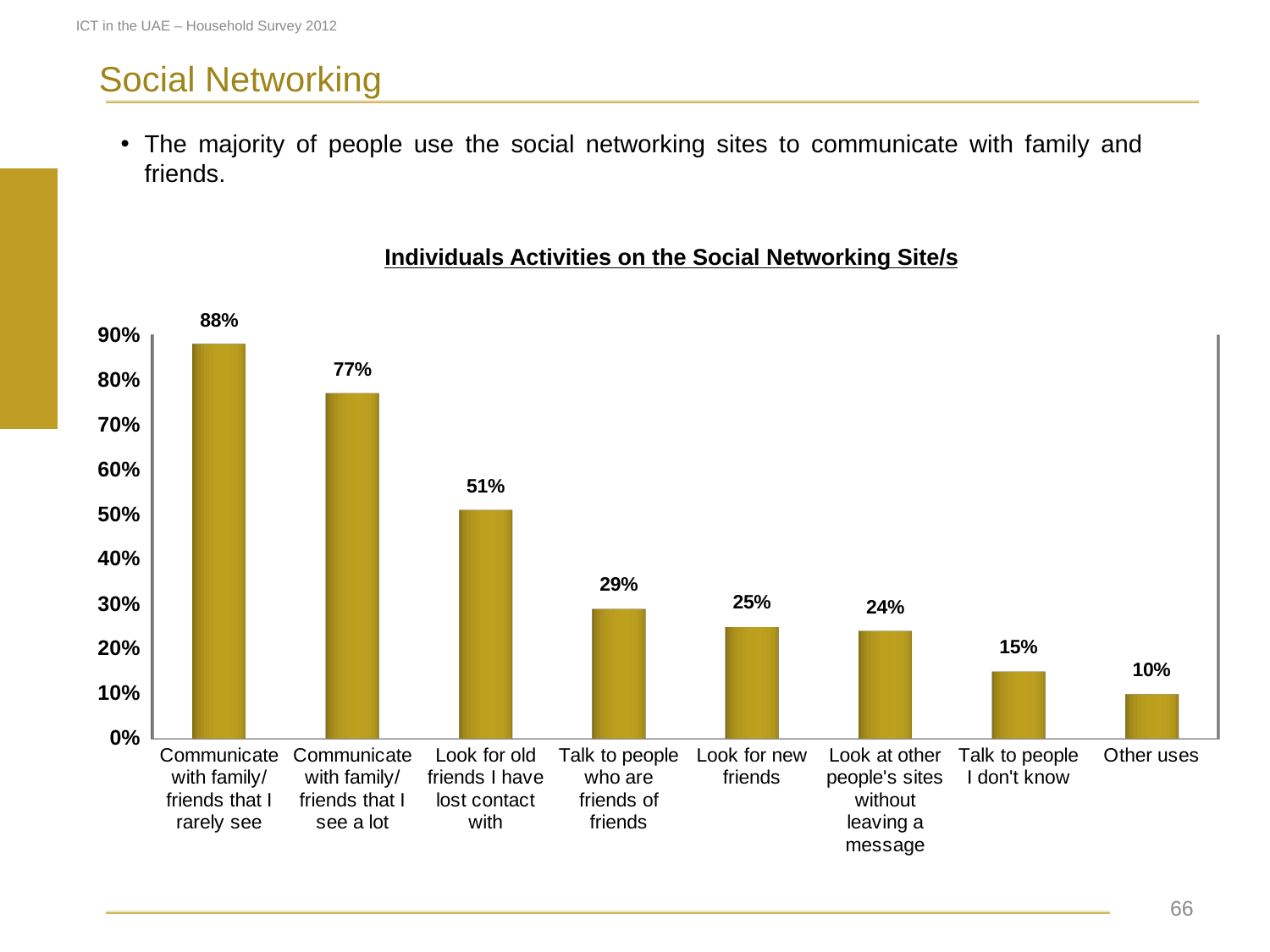
What is the value for 'Talk to people I don't know'? 15% Which is larger: 'Talk to people who are friends of friends' or 'Look for new friends'? Talk to people who are friends of friends Is the value for 'Look for old friends I have lost contact with' greater or less than 50%? greater What is the difference between 'Communicate with family/ friends that I rarely see' and 'Communicate with family/ friends that I see a lot'? 11% Which activity has the highest percentage? Communicate with family/ friends that I rarely see What is the difference between 'Look for new friends' and 'Look at other people's sites without leaving a message'? 1% How many activity categories are shown in the chart? 8 What is the value for 'Look for old friends I have lost contact with'? 51% What type of chart is shown on the slide? Bar chart Which activity has the lowest percentage? Other uses What percentage of individuals use social networking sites to communicate with family/friends that they rarely see? 88% What is the title of the chart? Individuals Activities on the Social Networking Site/s